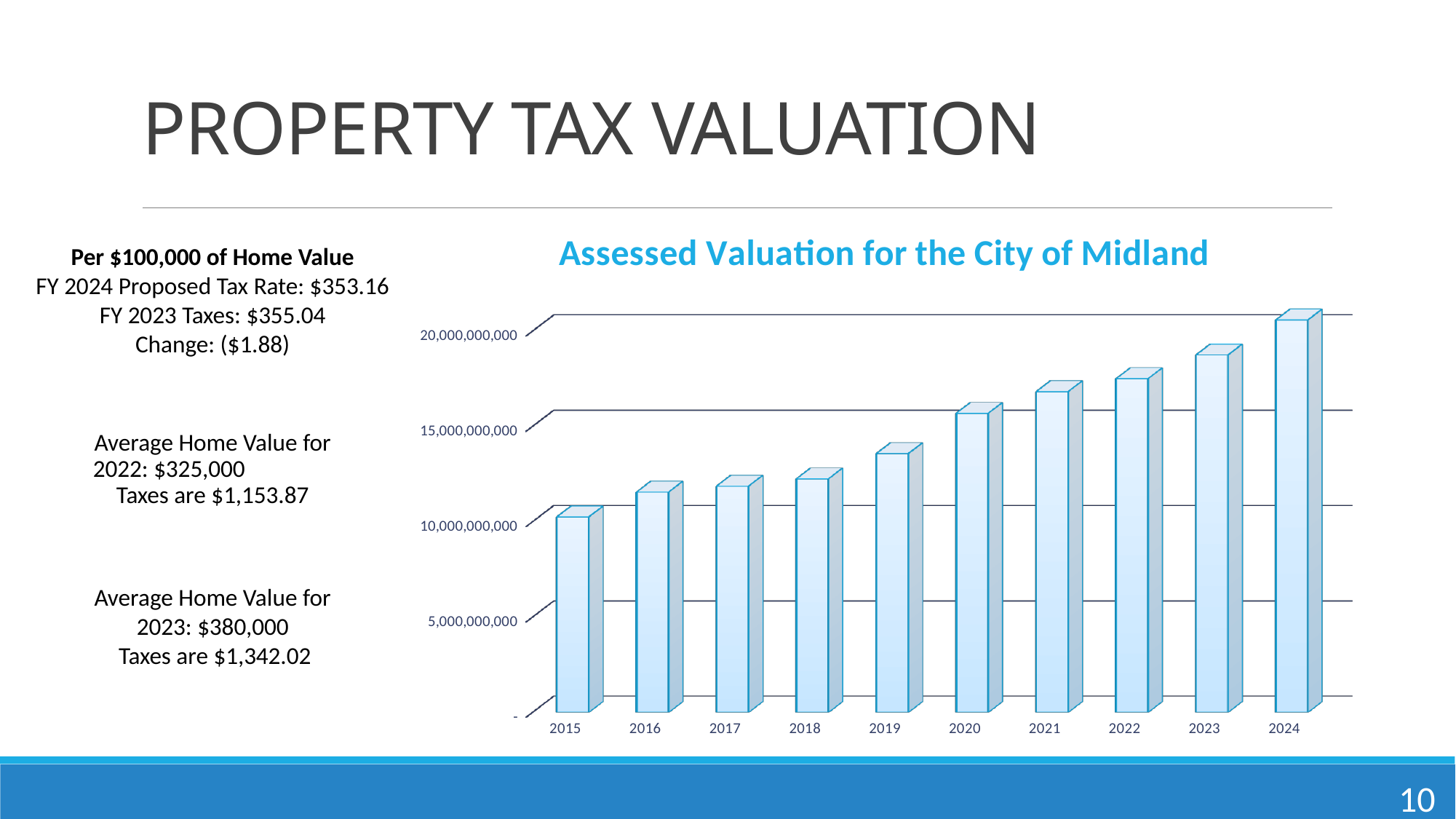
Is the assessed valuation for 2020 greater or less than 15,000,000,000? greater Is the assessed valuation for 2023 greater or less than 20,000,000,000? less Which year has the lowest assessed valuation? 2015 How many years are plotted on the x axis of the chart? 10 Which year has the highest assessed valuation? 2024 Which year has a larger assessed valuation, 2019 or 2020? 2020 Is the assessed valuation for 2019 greater or less than 15,000,000,000? less What is the title of the chart? Assessed Valuation for the City of Midland What type of chart is shown on the slide? bar chart Do the assessed valuation values rise or fall from 2015 to 2024? rise